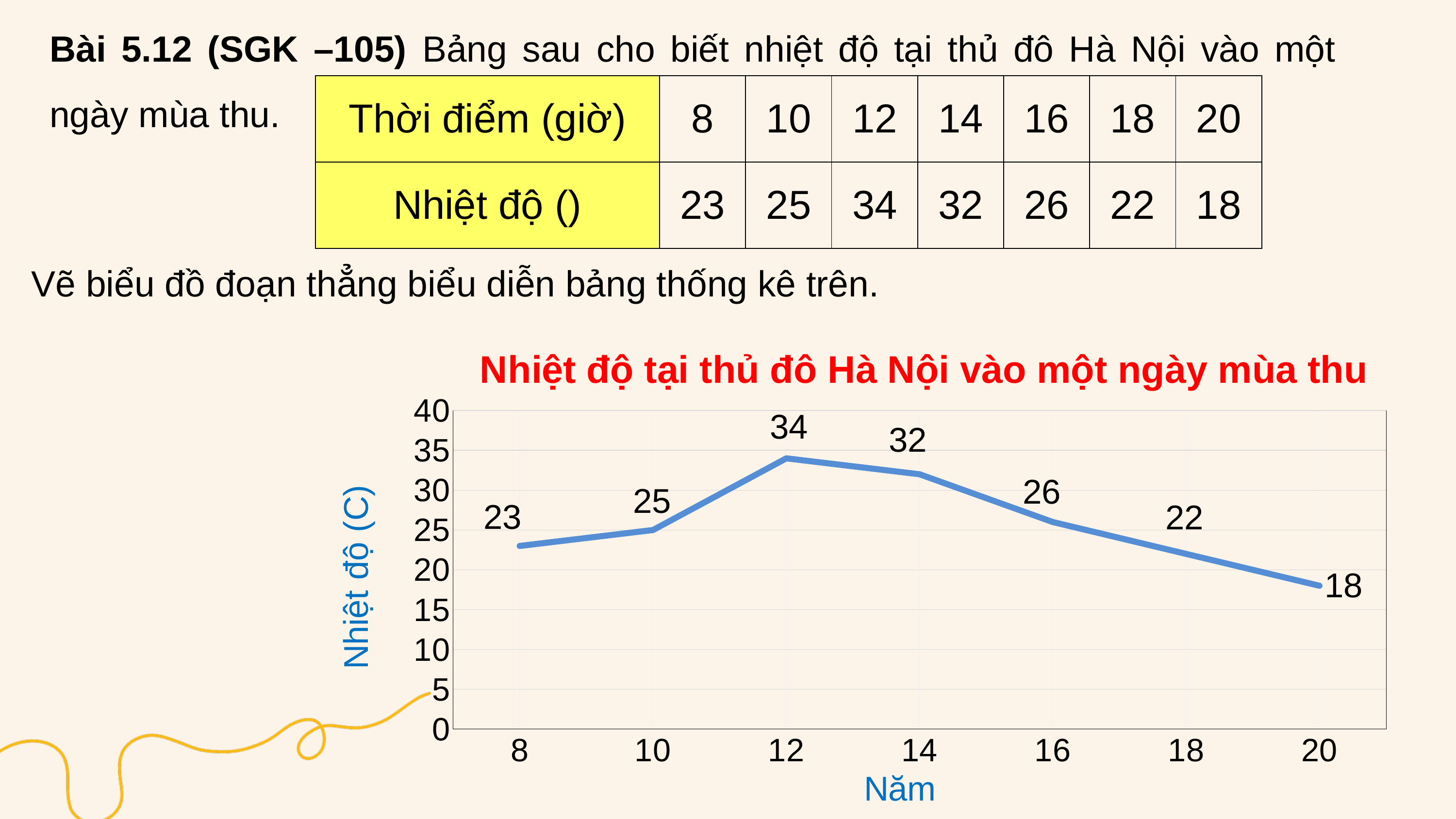
At which time is the temperature lowest? 20 What is the temperature at 8 o'clock in the chart? 23 Is the temperature at 16 o'clock greater or less than 30? less How many time points are plotted in the chart? 7 What is the difference between the temperature at 12 o'clock and at 20 o'clock? 16 What kind of chart is shown on the slide? line chart At which time is the temperature highest? 12 What is the temperature at 20 o'clock in the chart? 18 What is the temperature at 12 o'clock in the chart? 34 What is the title of the chart? Nhiệt độ tại thủ đô Hà Nội vào một ngày mùa thu What is the difference between the temperature at 14 o'clock and at 16 o'clock? 6 Which is larger, the temperature at 10 o'clock or at 18 o'clock? 10 o'clock